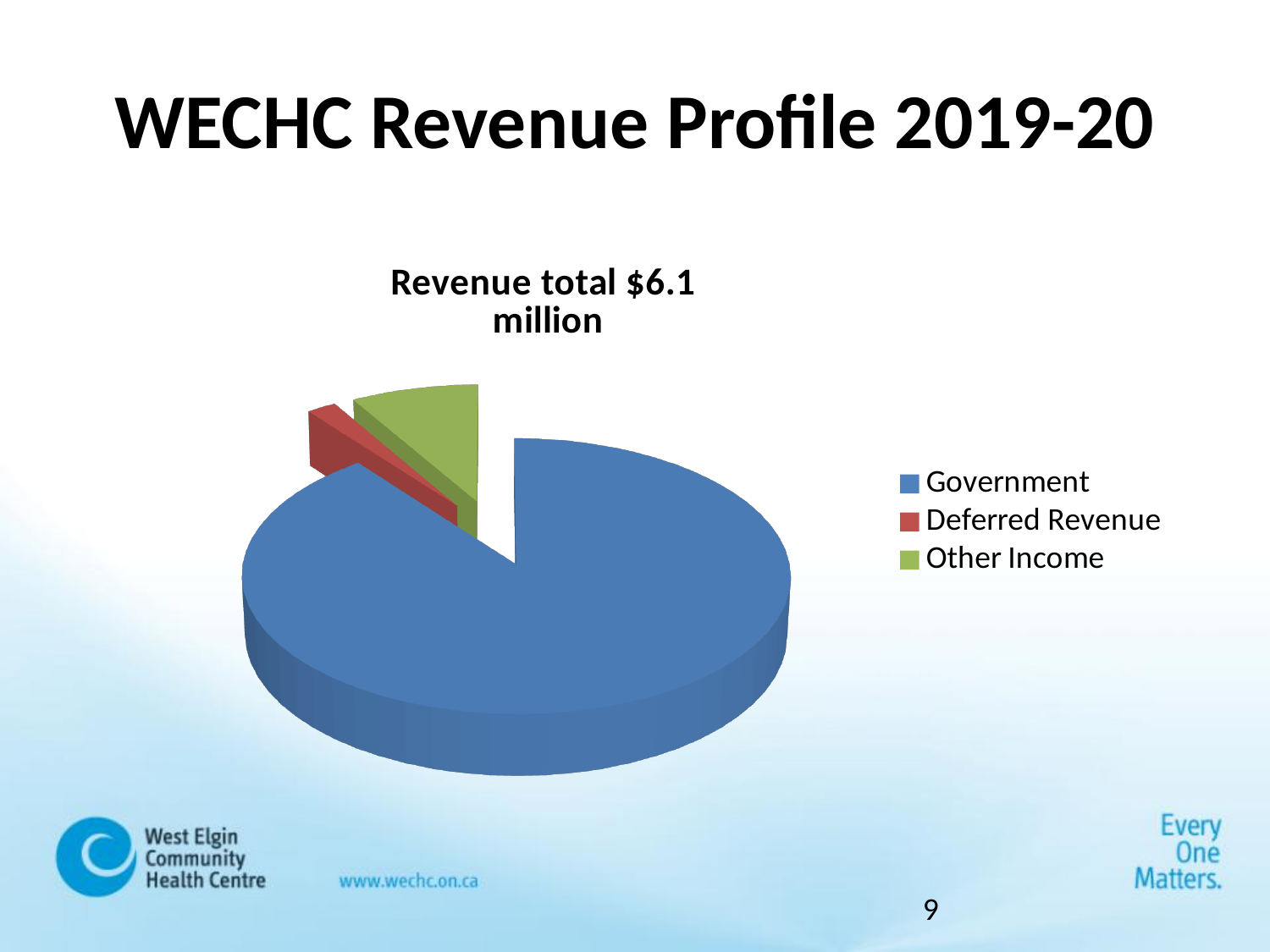
Which category is shown in green? Other Income What kind of chart is shown on the slide? pie chart Which colour represents Government in the chart? blue Which category has the smallest slice of the pie? Deferred Revenue How many categories does the legend list? 3 Which category has the largest slice of the pie? Government Which slice is larger, Other Income or Deferred Revenue? Other Income Which slice is larger, Government or Other Income? Government What is the title of the chart? Revenue total $6.1 million What total revenue is stated in the chart title? $6.1 million